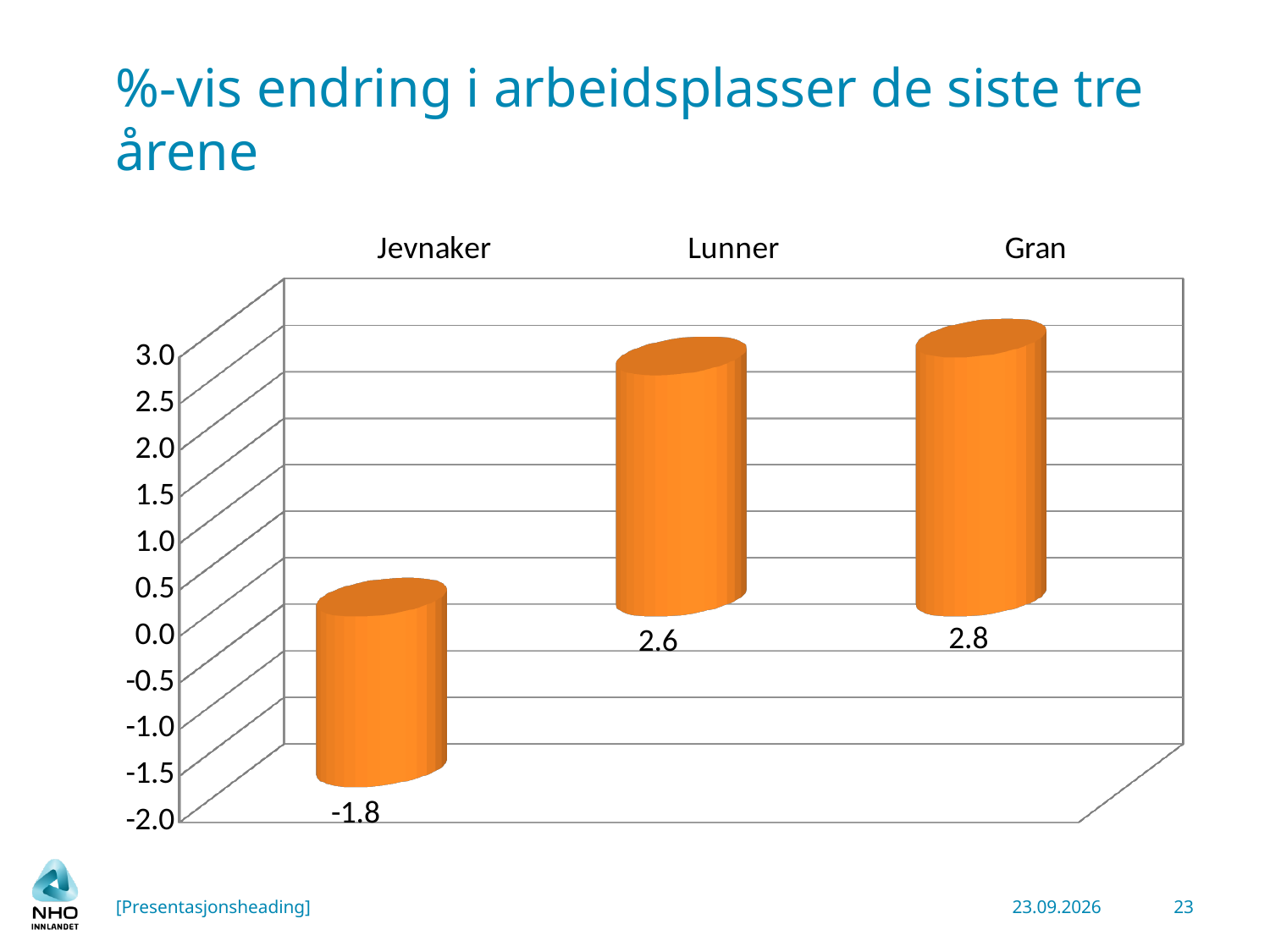
Which category has the lowest value? Jevnaker How many categories are shown in the chart? 3 Which category has the highest value? Gran What kind of chart is shown on the slide? bar chart What is the difference between the values for Gran and Lunner? 0.2 What is the value for Gran? 2.8 What is the value for Jevnaker? -1.8 Which is larger, the value for Lunner or the value for Jevnaker? Lunner What is the title of the slide? %-vis endring i arbeidsplasser de siste tre årene Is the value for Jevnaker greater or less than 0.0? less What is the value for Lunner? 2.6 What is the difference between the values for Lunner and Jevnaker? 4.4